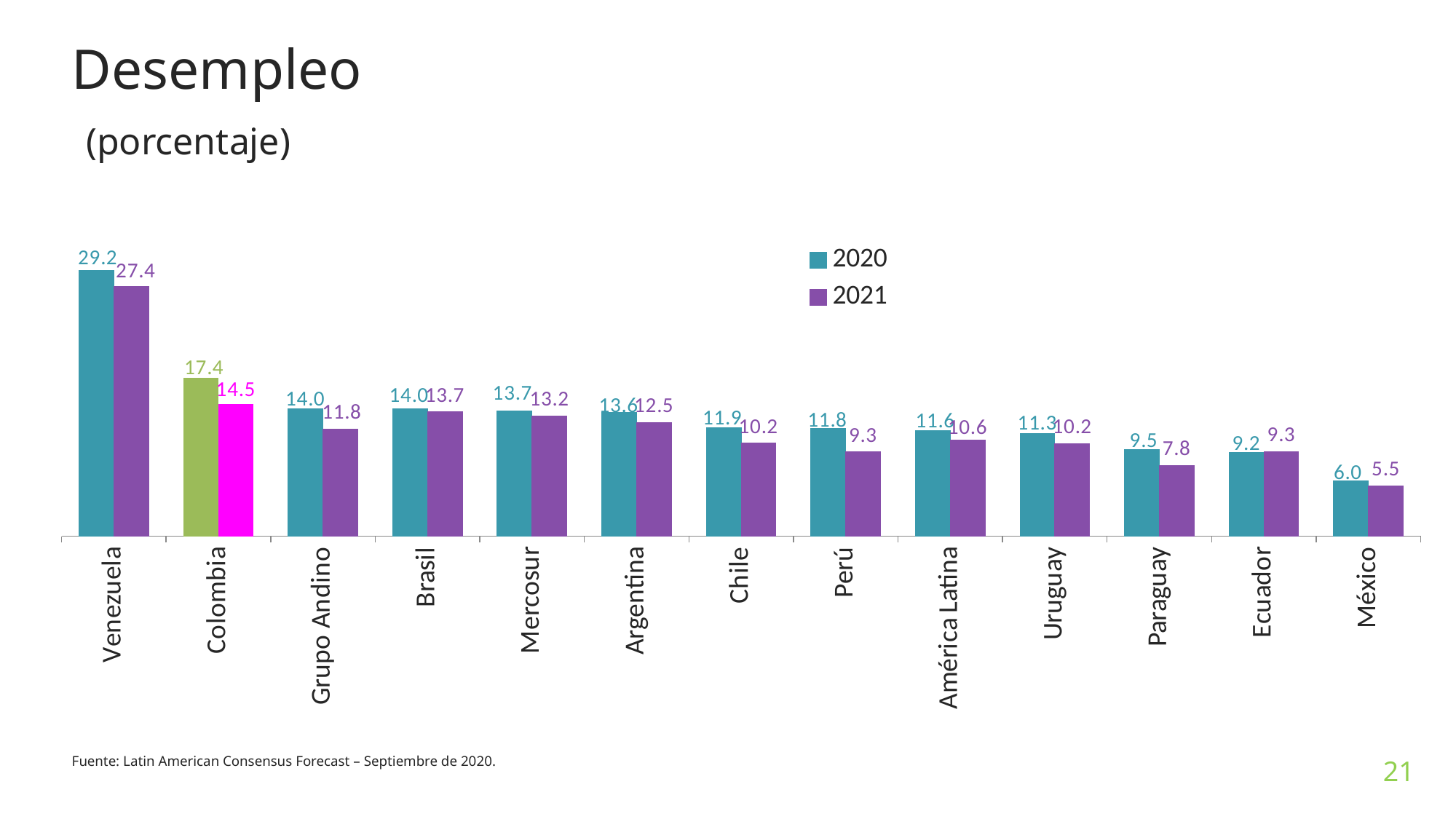
Which category has the highest 2020 value? Venezuela What kind of chart is shown on the slide? Bar chart What is the 2021 value for Perú? 9.3 Which is larger for Ecuador, the 2020 value or the 2021 value? 2021 How many series does the legend list? 2 Which category has the lowest 2021 value? México What is the 2021 unemployment value for Colombia? 14.5 How many categories are shown on the x axis? 13 What is the title of the chart? Desempleo (porcentaje) What is the 2020 unemployment value for Venezuela? 29.2 What is the difference between the 2020 and 2021 values for Colombia? 2.9 What is the difference between the 2020 and 2021 values for Venezuela? 1.8